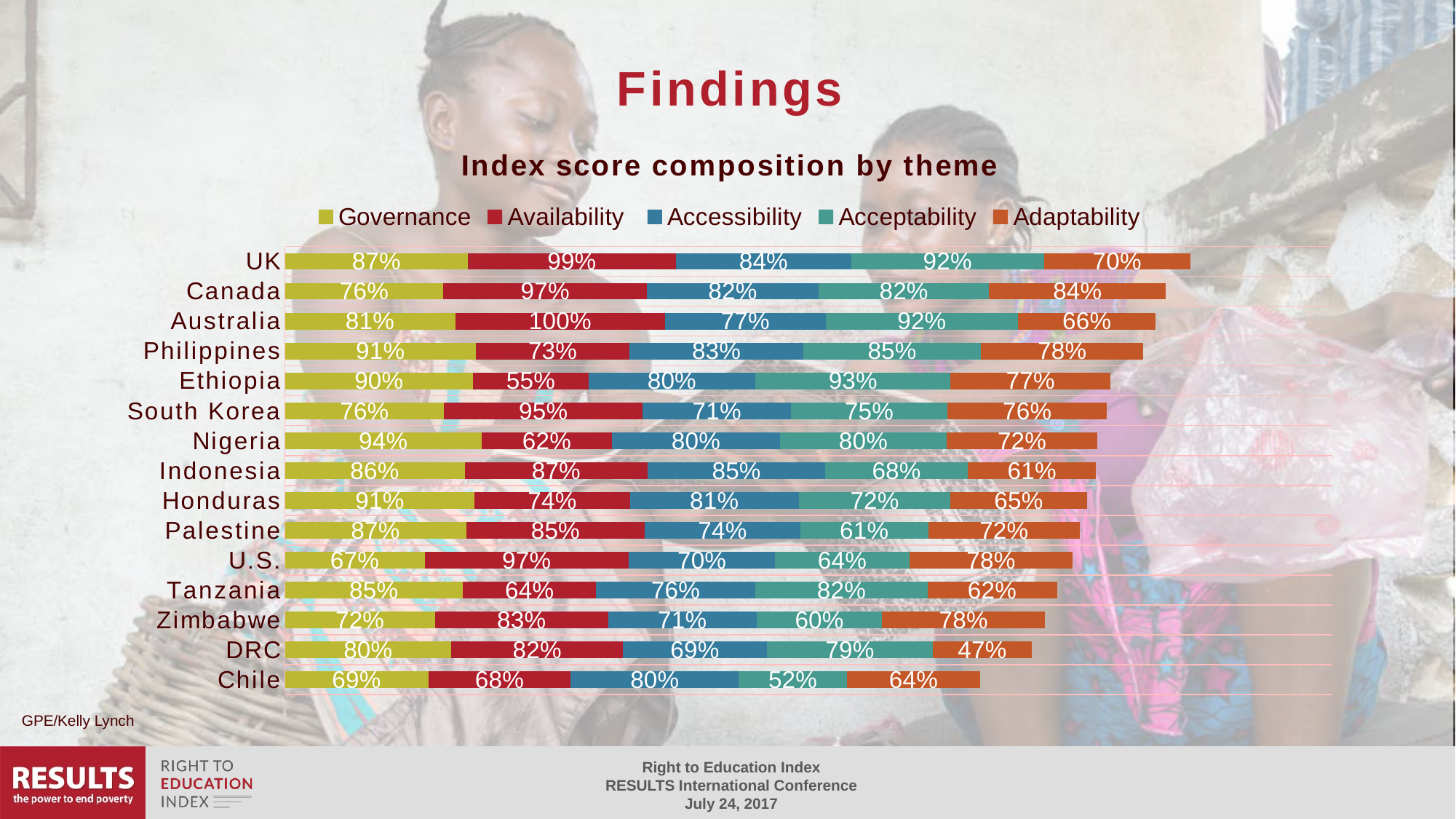
What kind of chart is shown on the slide? Stacked bar chart Which country has the highest Governance score? Nigeria Which is larger, the Accessibility score for Indonesia or for South Korea? Indonesia What is the total of the five theme scores for Chile? 333% How many countries are shown in the chart? 15 What is the Availability score for Australia? 100% What is the title of the chart? Index score composition by theme What is the Adaptability score for Canada? 84% Which country has the lowest Adaptability score? DRC What is the Acceptability score for Chile? 52% What is the difference between the Availability scores of the UK and Ethiopia? 44 percentage points How many series does the legend list? 5